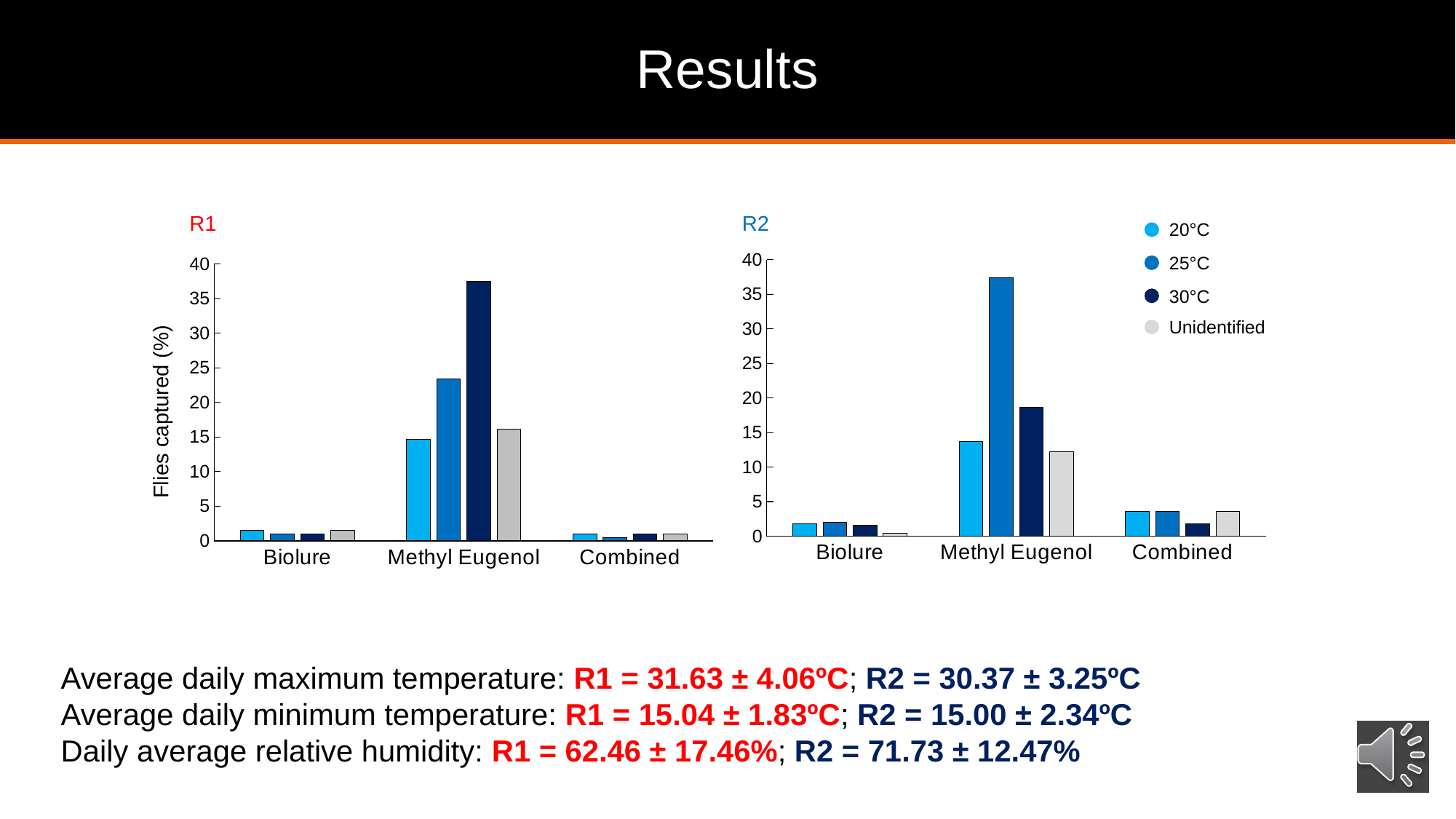
In the R2 chart, which is larger for Methyl Eugenol: the 20°C bar or the 30°C bar? 30°C How many categories are shown on the x axis of the R2 chart? 3 In the R1 chart, which series has the highest bar for Methyl Eugenol? 30°C In the R1 chart, which category has the highest bars overall? Methyl Eugenol What is the y-axis label of the R1 chart? Flies captured (%) Which series is shown in grey in the legend? Unidentified In the R2 chart, which series has the highest bar for Methyl Eugenol? 25°C In the R2 chart, is the value for Methyl Eugenol at 30°C greater or less than 20? less How many series does the legend list for the charts? 4 In the R1 chart, is the value for Methyl Eugenol at 30°C greater or less than 35? greater What kind of chart is the R1 chart? bar chart In the R1 chart, is the value for Methyl Eugenol at 25°C greater or less than 20? greater